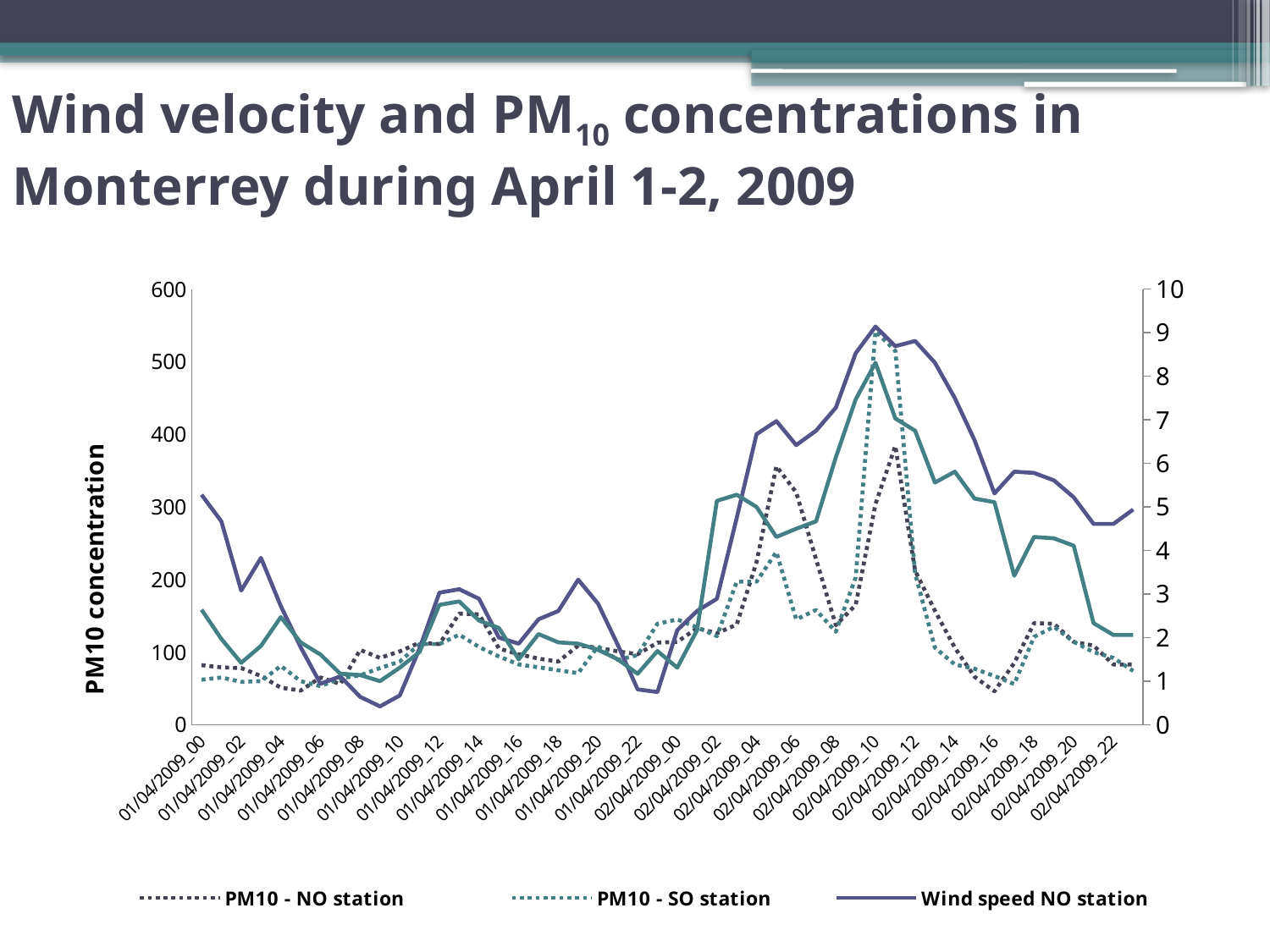
Does the PM10 - SO station line rise or fall between 02/04/2009_08 and 02/04/2009_10? rise What kind of chart is shown on the slide? line chart Is the value for PM10 - NO station at 02/04/2009_10 greater or less than 500? less Is the value for Wind speed NO station at 01/04/2009_08 greater or less than 1 on the right axis? less Is the value for PM10 - SO station at 02/04/2009_10 greater or less than 400? greater Does the Wind speed NO station line rise or fall between 02/04/2009_12 and 02/04/2009_16? fall Which legend entry is drawn as a solid line? Wind speed NO station How many series does the legend list? 3 What is the title of the left vertical axis? PM10 concentration